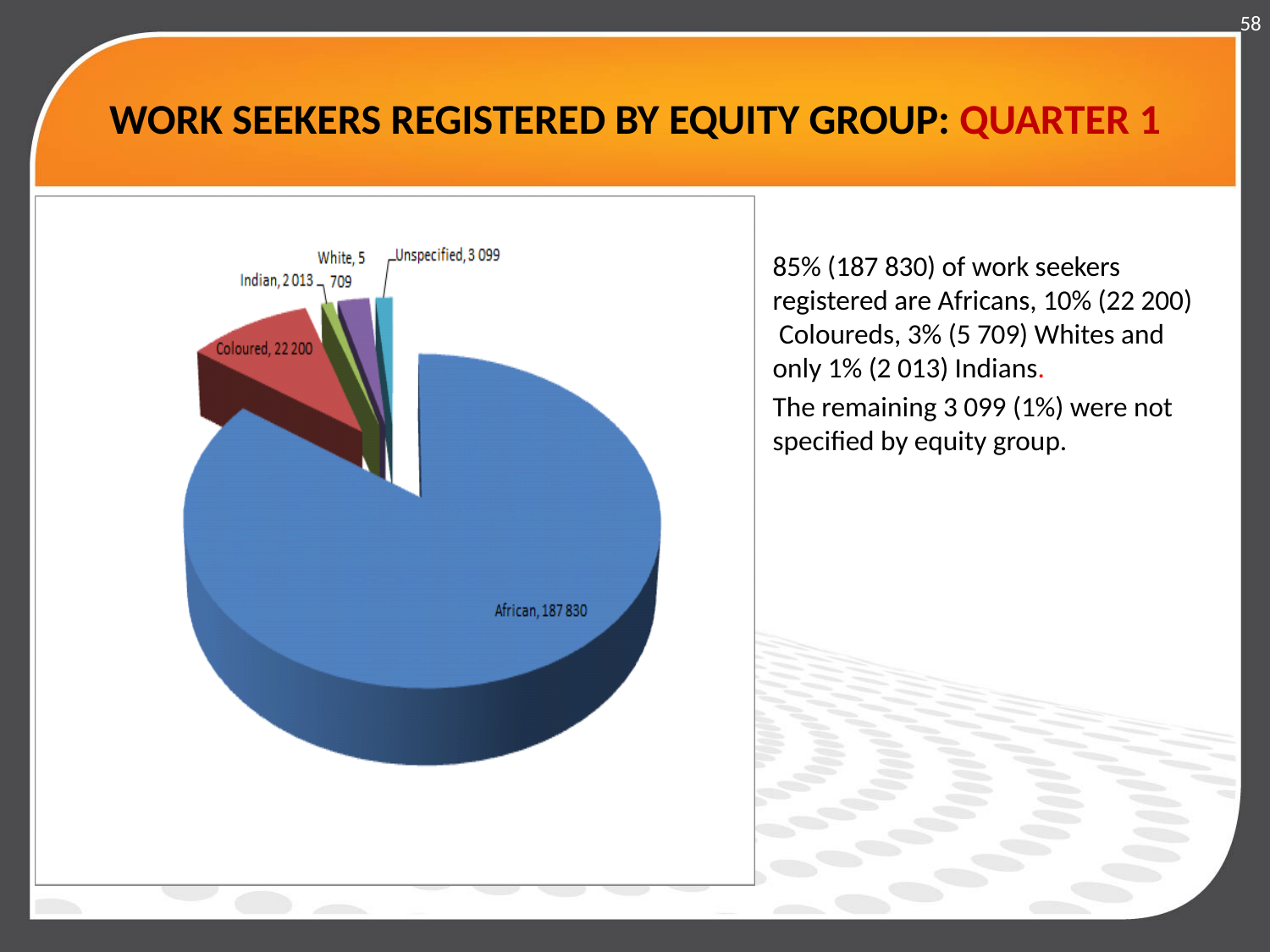
What kind of chart is shown on the slide? pie chart What is the value shown for Coloured work seekers? 22 200 What colour is the African slice of the pie? blue What is the value shown for the Unspecified group? 3 099 Which equity group has the smallest slice of the pie? Indian What share of registered work seekers are African, as stated on the slide? 85% How many equity groups (slices) does the pie chart show? 5 What is the difference between the African and Coloured values? 165 630 How many work seekers registered are African according to the chart? 187 830 What is the value shown for Indian work seekers? 2 013 Which equity group has the largest slice of the pie? African Which is larger, the value for White or the value for Unspecified? White